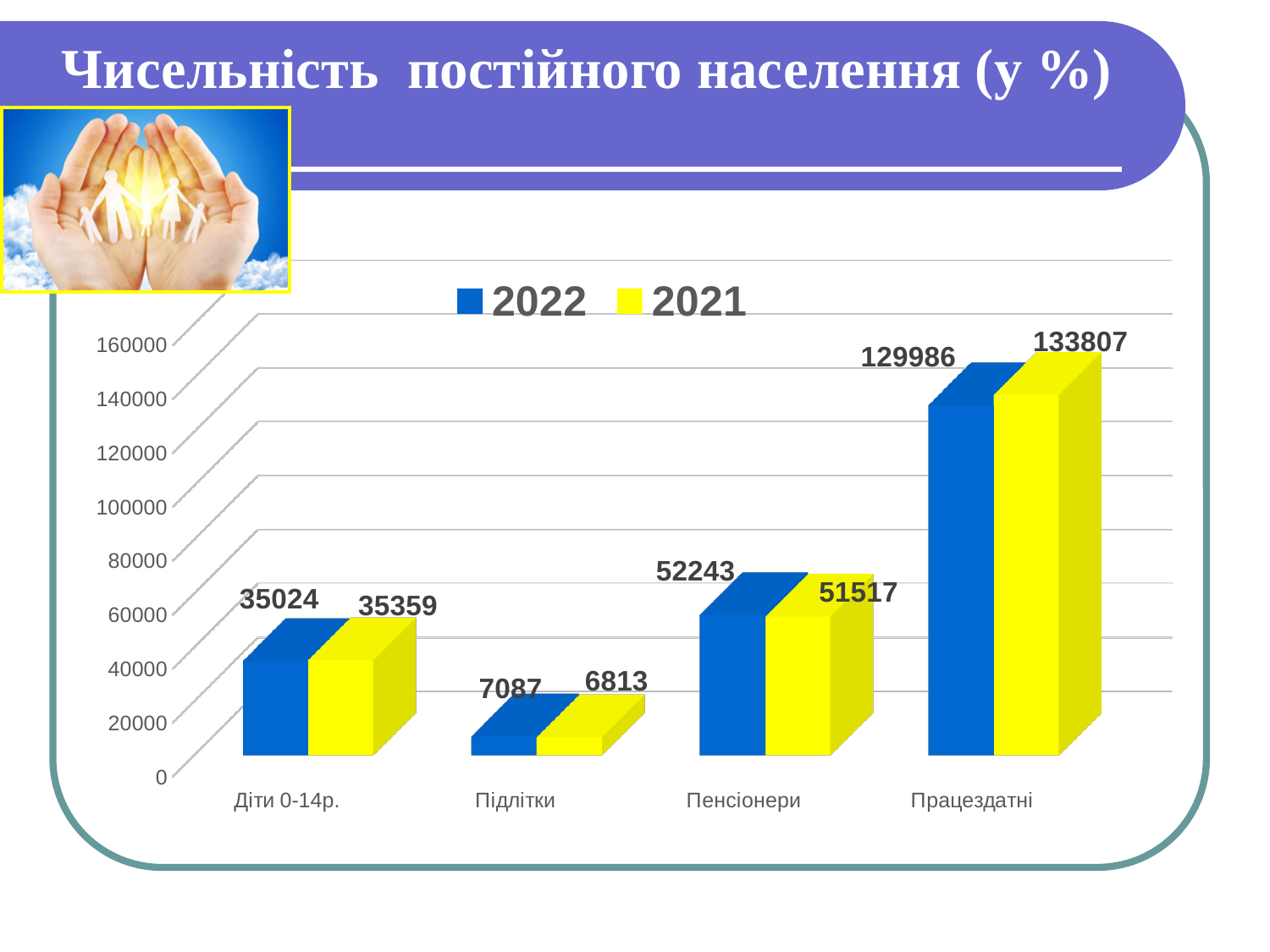
What is the difference between the 2022 and 2021 values for Пенсіонери? 726 Which is larger for Підлітки: the 2022 value or the 2021 value? 2022 How many categories are shown on the x axis? 4 Which category has the lowest value in the 2022 series? Підлітки What kind of chart is shown on the slide? Bar chart What is the value for Діти 0-14р. in the 2021 series? 35359 Which category has the highest value in the 2021 series? Працездатні What is the value for Підлітки in the 2021 series? 6813 What is the value for Пенсіонери in the 2022 series? 52243 How many series does the legend list? 2 What is the value for Працездатні in the 2022 series? 129986 What is the difference between the 2021 and 2022 values for Працездатні? 3821